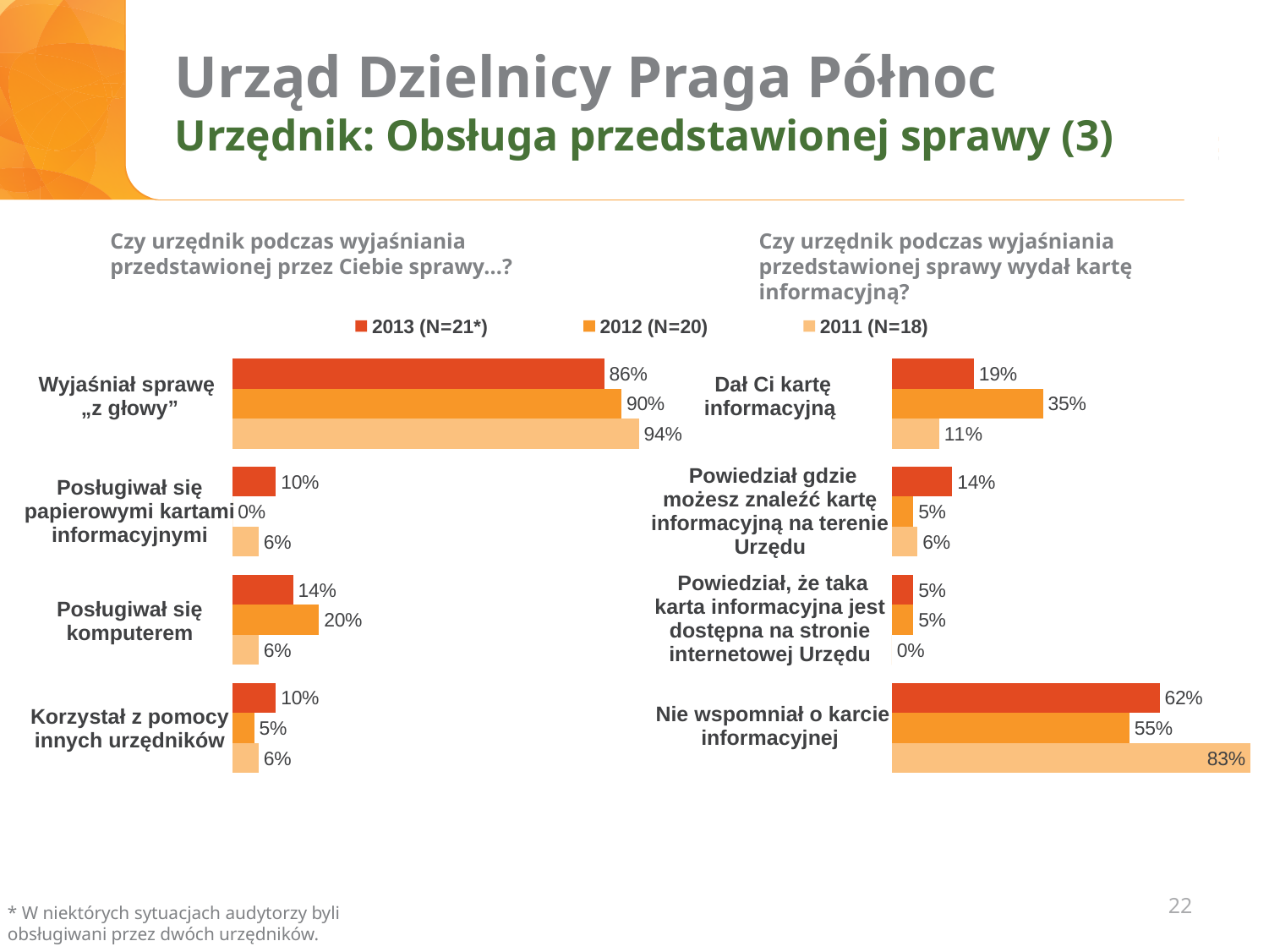
In the right chart, which is larger for "Dał Ci kartę informacyjną": the 2013 value or the 2011 value? 2013 In the right chart, which year has the lowest value for "Nie wspomniał o karcie informacyjnej"? 2012 (N=20) In the left chart, what is the 2012 value for "Posługiwał się komputerem"? 20% In the right chart, what is the difference between the 2013 and 2012 values for "Nie wspomniał o karcie informacyjnej"? 7 percentage points How many categories does the left chart show? 4 In the left chart, what is the difference between the 2011 and 2013 values for "Wyjaśniał sprawę „z głowy”"? 8 percentage points In the right chart, what is the 2012 value for "Dał Ci kartę informacyjną"? 35% In the left chart ("Czy urzędnik podczas wyjaśniania przedstawionej przez Ciebie sprawy...?"), what is the 2013 value for "Wyjaśniał sprawę „z głowy”"? 86% In the left chart, which year has the highest value for "Wyjaśniał sprawę „z głowy”"? 2011 (N=18) How many series does the legend list? 3 In the right chart ("Czy urzędnik podczas wyjaśniania przedstawionej sprawy wydał kartę informacyjną?"), what is the 2011 value for "Nie wspomniał o karcie informacyjnej"? 83% What type of chart is used on this slide? Bar chart